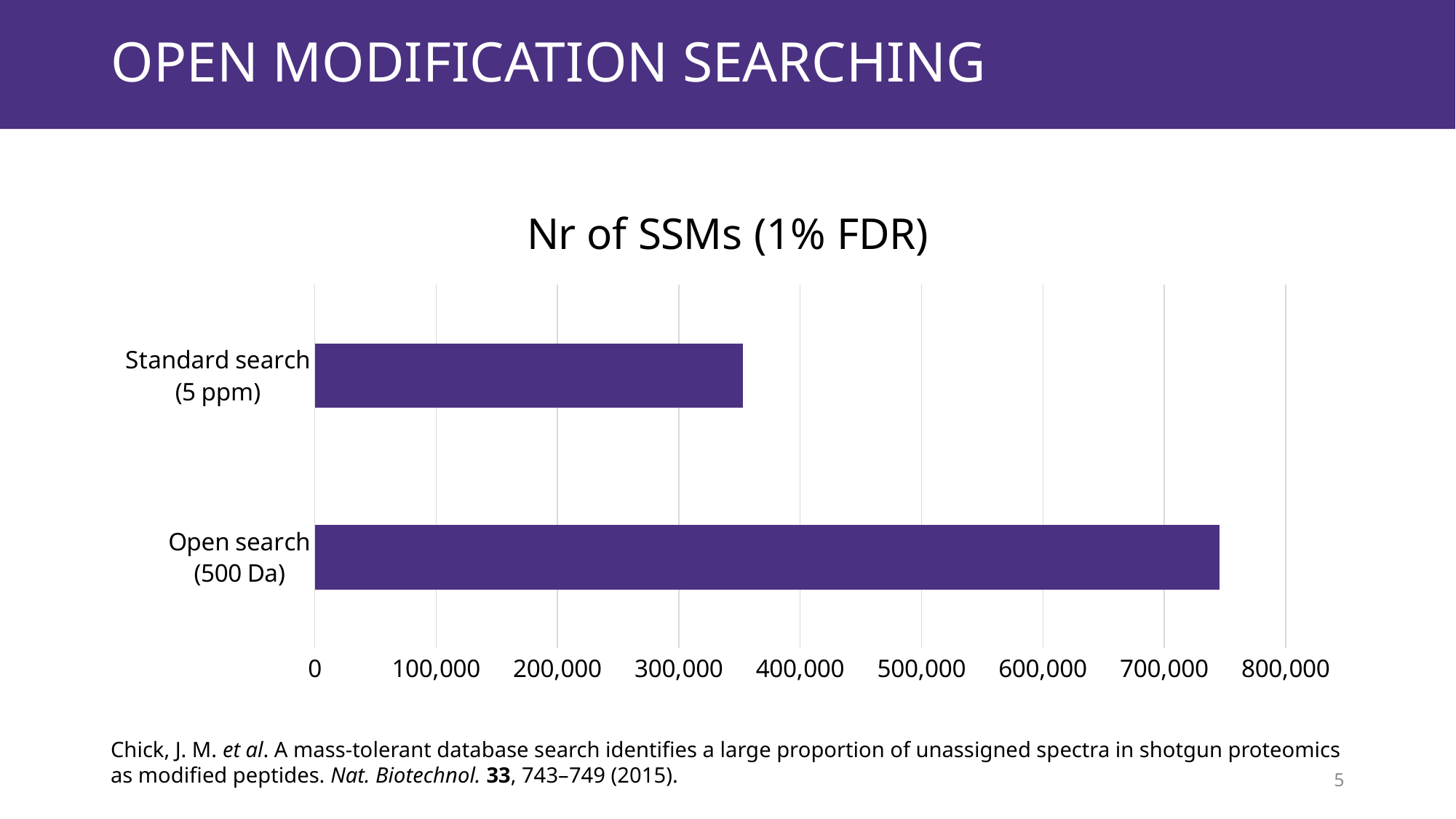
Is the value for Open search (500 Da) greater or less than 800,000? less How many categories are plotted in the chart? 2 Is the value for Standard search (5 ppm) greater or less than 400,000? less Which category has the highest number of SSMs? Open search (500 Da) What is the maximum value shown on the horizontal axis? 800,000 Is the value for Standard search (5 ppm) greater or less than 300,000? greater Which has more SSMs, Standard search (5 ppm) or Open search (500 Da)? Open search (500 Da) Which category has the lowest number of SSMs? Standard search (5 ppm) What is the title of the chart? Nr of SSMs (1% FDR) What kind of chart is shown on the slide? bar chart